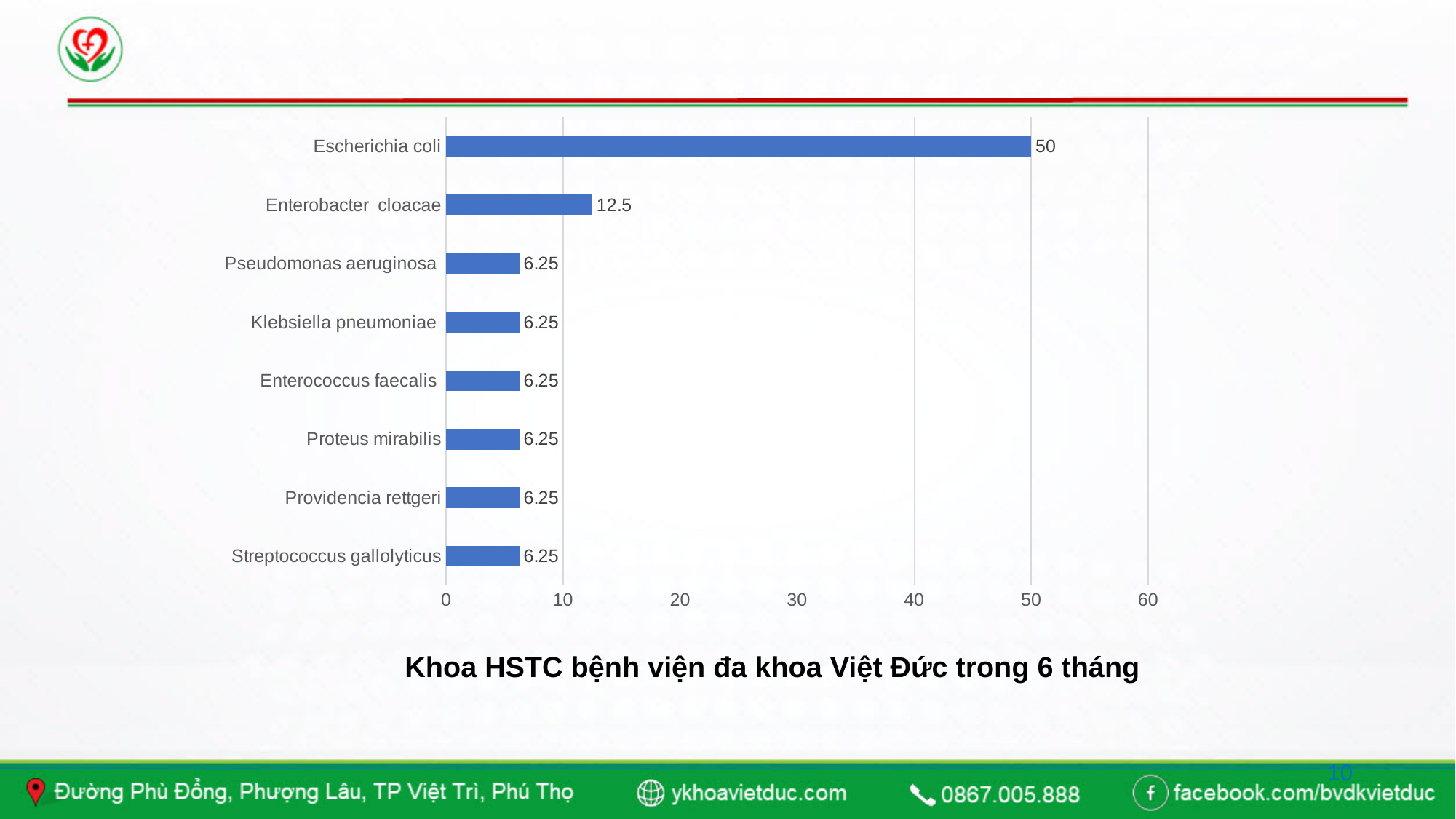
What is the caption text shown below the chart? Khoa HSTC bệnh viện đa khoa Việt Đức trong 6 tháng What is the difference between the values for Enterobacter cloacae and Klebsiella pneumoniae? 6.25 Is the value for Escherichia coli greater or less than 40? greater How many categories are shown in the chart? 8 What is the difference between the values for Escherichia coli and Enterobacter cloacae? 37.5 What is the value for Streptococcus gallolyticus? 6.25 What is the value for Enterobacter cloacae? 12.5 What kind of chart is shown on the slide? bar chart What is the value for Escherichia coli? 50 Which category has the highest value? Escherichia coli Which is larger, the value for Enterobacter cloacae or the value for Proteus mirabilis? Enterobacter cloacae What is the value for Pseudomonas aeruginosa? 6.25